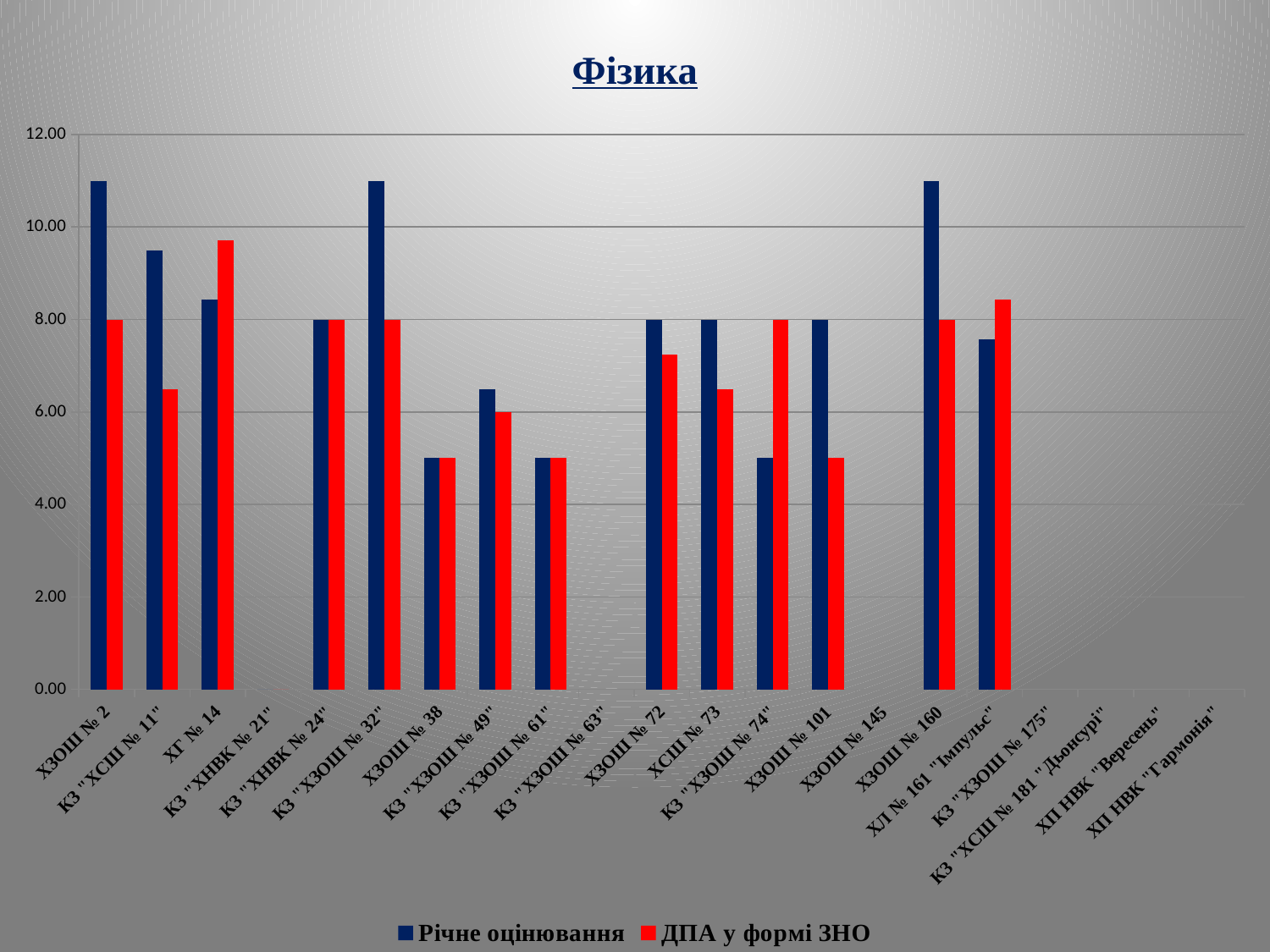
Is the value of ДПА у формі ЗНО for ХГ № 14 greater or less than 10.00? less What is the value of ДПА у формі ЗНО for ХЗОШ № 2? 8.00 What is the value of ДПА у формі ЗНО for КЗ "ХЗОШ № 49"? 6.00 Is the value of Річне оцінювання for ХЗОШ № 160 greater or less than 10.00? greater What is the title of the chart? Фізика For ХГ № 14, which is larger: Річне оцінювання or ДПА у формі ЗНО? ДПА у формі ЗНО How many categories are shown on the x axis? 21 What kind of chart is shown on the slide? bar chart What is the value of Річне оцінювання for ХЗОШ № 101? 8.00 Which category has the highest value of ДПА у формі ЗНО? ХГ № 14 How many series does the legend list? 2 Is the value of Річне оцінювання for КЗ "ХЗОШ № 61" greater or less than 6.00? less